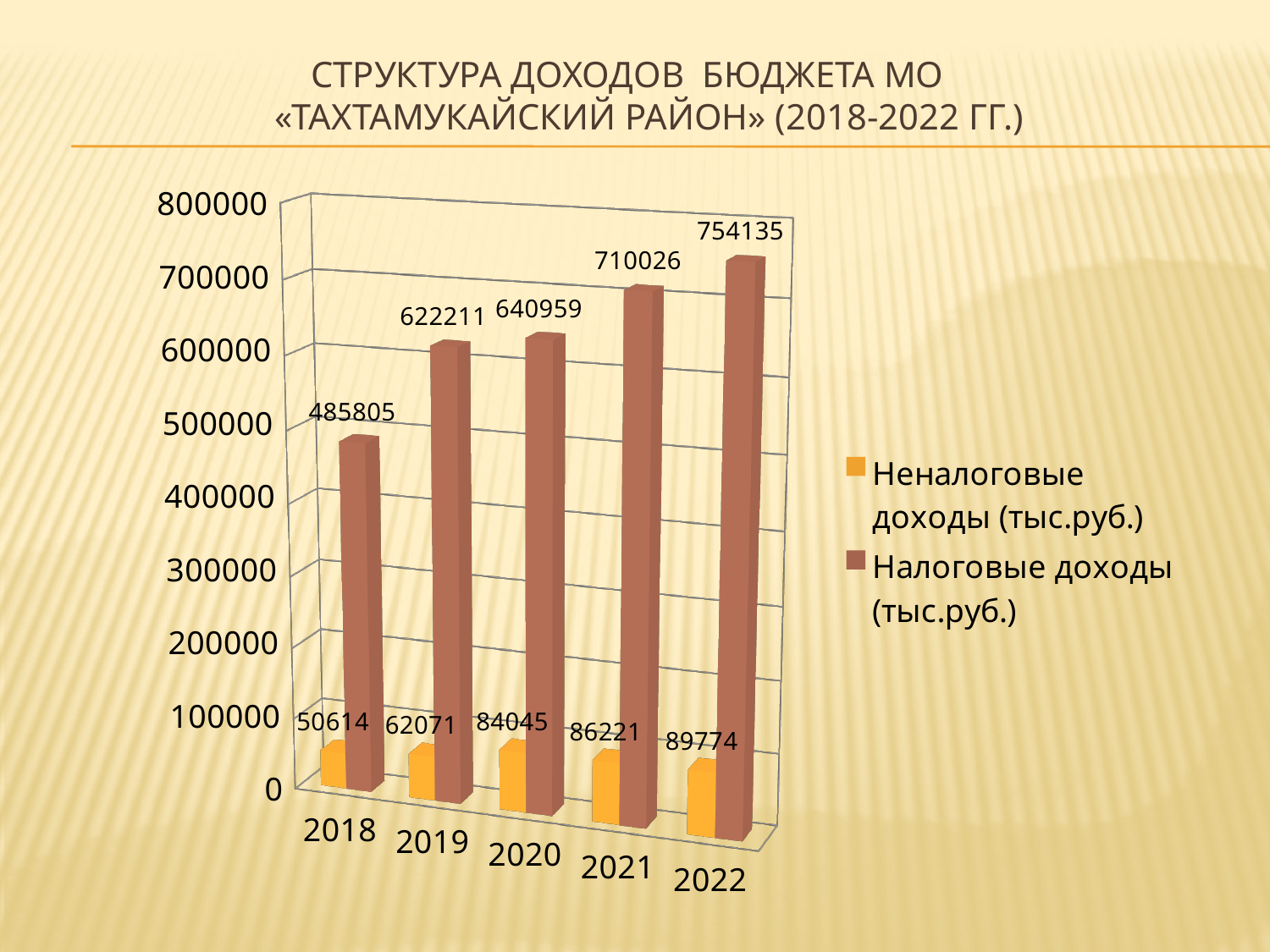
What is the value of Налоговые доходы (тыс.руб.) for 2022? 754135 How many series does the legend list? 2 What is the value of Налоговые доходы (тыс.руб.) for 2020? 640959 In which year is Налоговые доходы (тыс.руб.) the lowest? 2018 What kind of chart is shown on the slide? Bar chart In which year is Неналоговые доходы (тыс.руб.) the highest? 2022 Which is larger: Неналоговые доходы (тыс.руб.) in 2019 or in 2020? 2020 How many years are shown on the x axis? 5 What is the value of Неналоговые доходы (тыс.руб.) for 2021? 86221 Do the values of Налоговые доходы (тыс.руб.) rise or fall from 2018 to 2022? Rise What is the value of Неналоговые доходы (тыс.руб.) for 2018? 50614 What is the difference between Налоговые доходы (тыс.руб.) in 2022 and in 2018? 268330